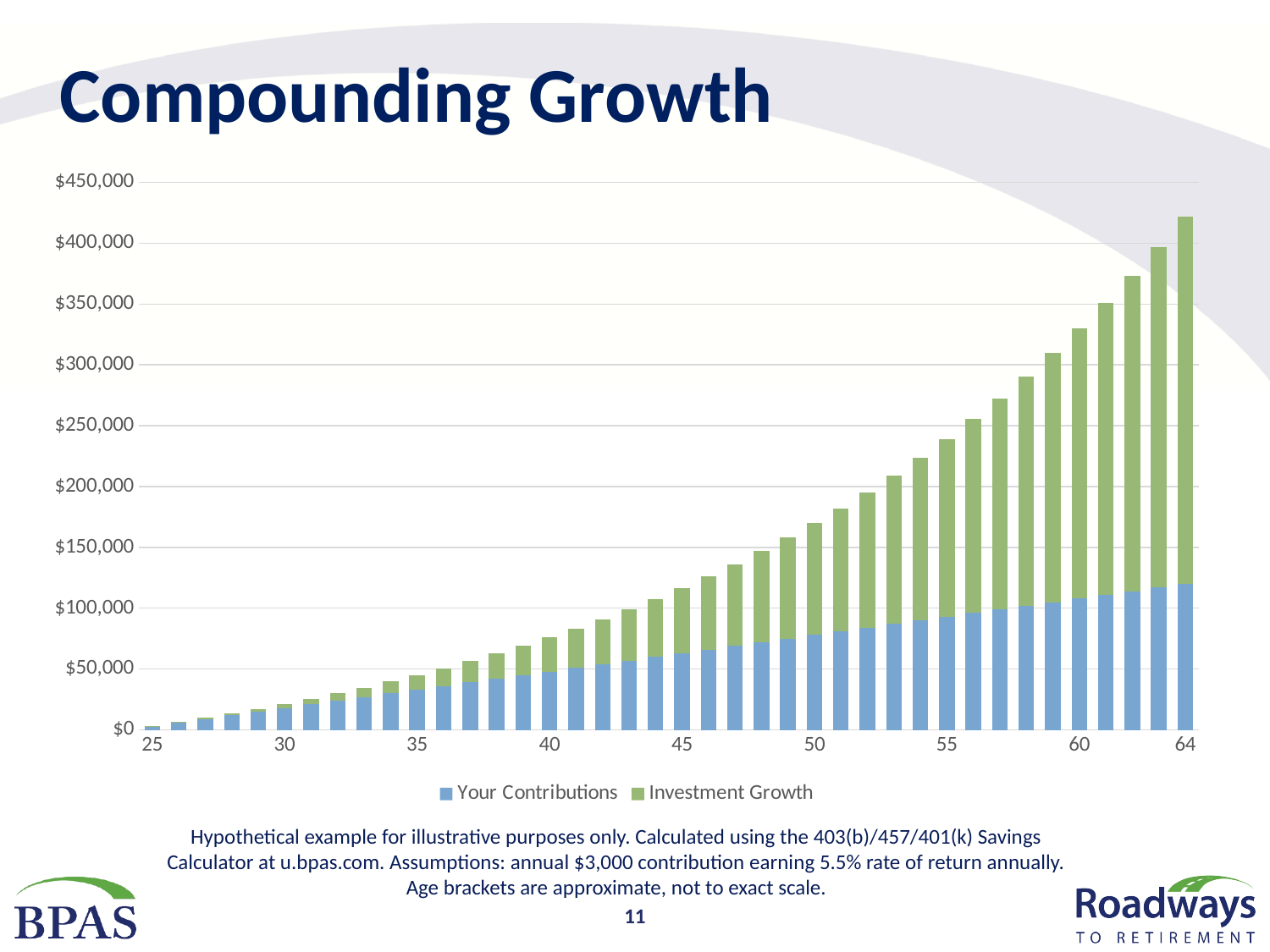
How many series does the legend list? 2 Is the total value at age 60 greater or less than $300,000? greater Do the total bar heights rise or fall as age increases along the x axis? Rise Is the total value at age 64 greater or less than $400,000? greater At age 64, which is larger: Your Contributions or Investment Growth? Investment Growth What are the two series named in the legend? Your Contributions and Investment Growth What is the title of the chart? Compounding Growth What kind of chart is shown on the slide? Stacked bar chart Is the total value at age 30 greater or less than $50,000? less At which age is the total bar the highest? 64 At which age is the total bar the lowest? 25